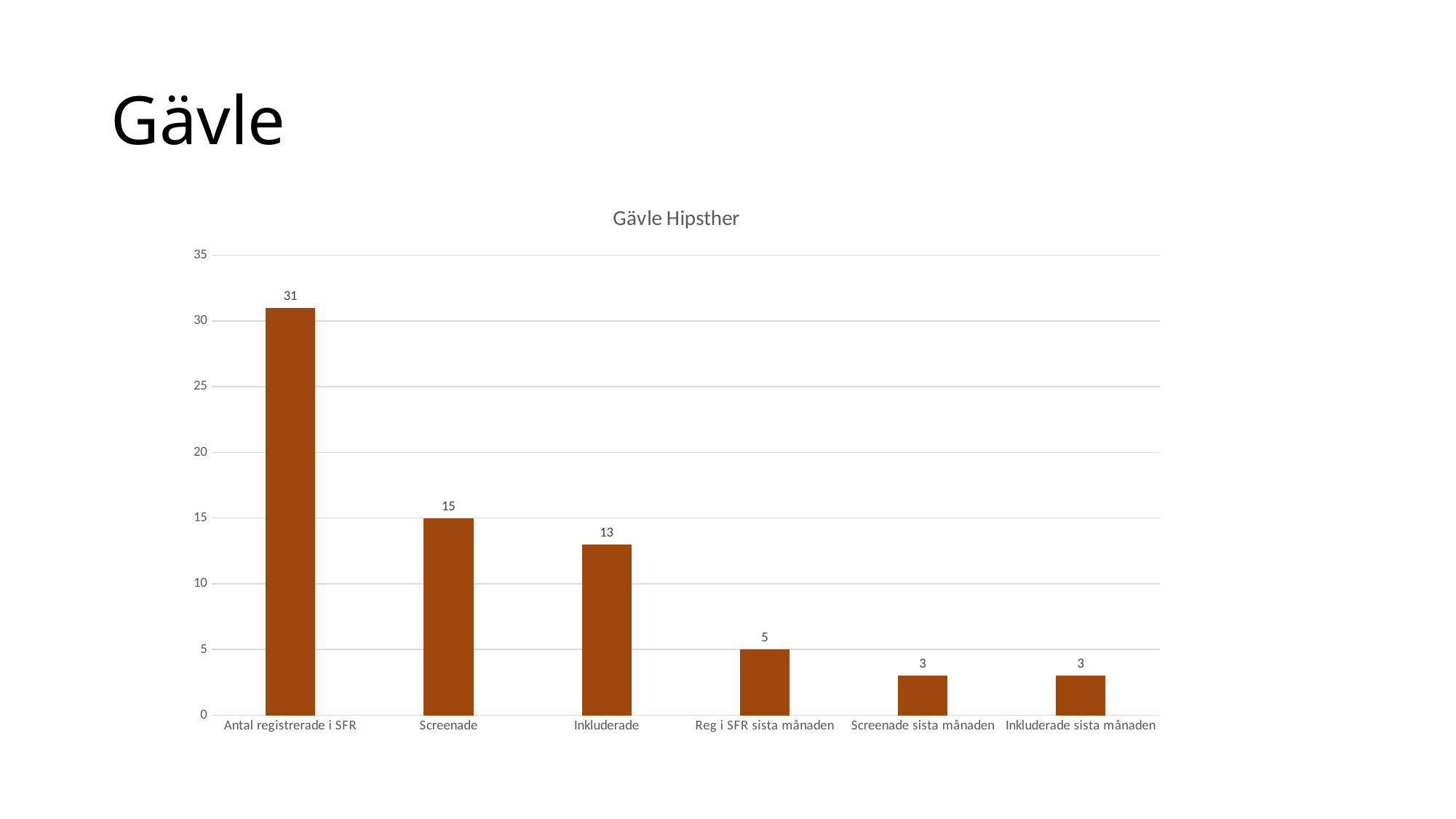
Which is larger, Inkluderade or Reg i SFR sista månaden? Inkluderade What is the difference between Screenade and Inkluderade? 2 What is the value for Inkluderade? 13 Is the value for Antal registrerade i SFR greater or less than 30? greater What is the title of the chart? Gävle Hipsther Which category has the highest value? Antal registrerade i SFR What kind of chart is this? bar chart What is the difference between Antal registrerade i SFR and Screenade? 16 How many categories are shown on the x axis? 6 What is the value for Screenade? 15 What is the value for Antal registrerade i SFR? 31 What is the value for Reg i SFR sista månaden? 5